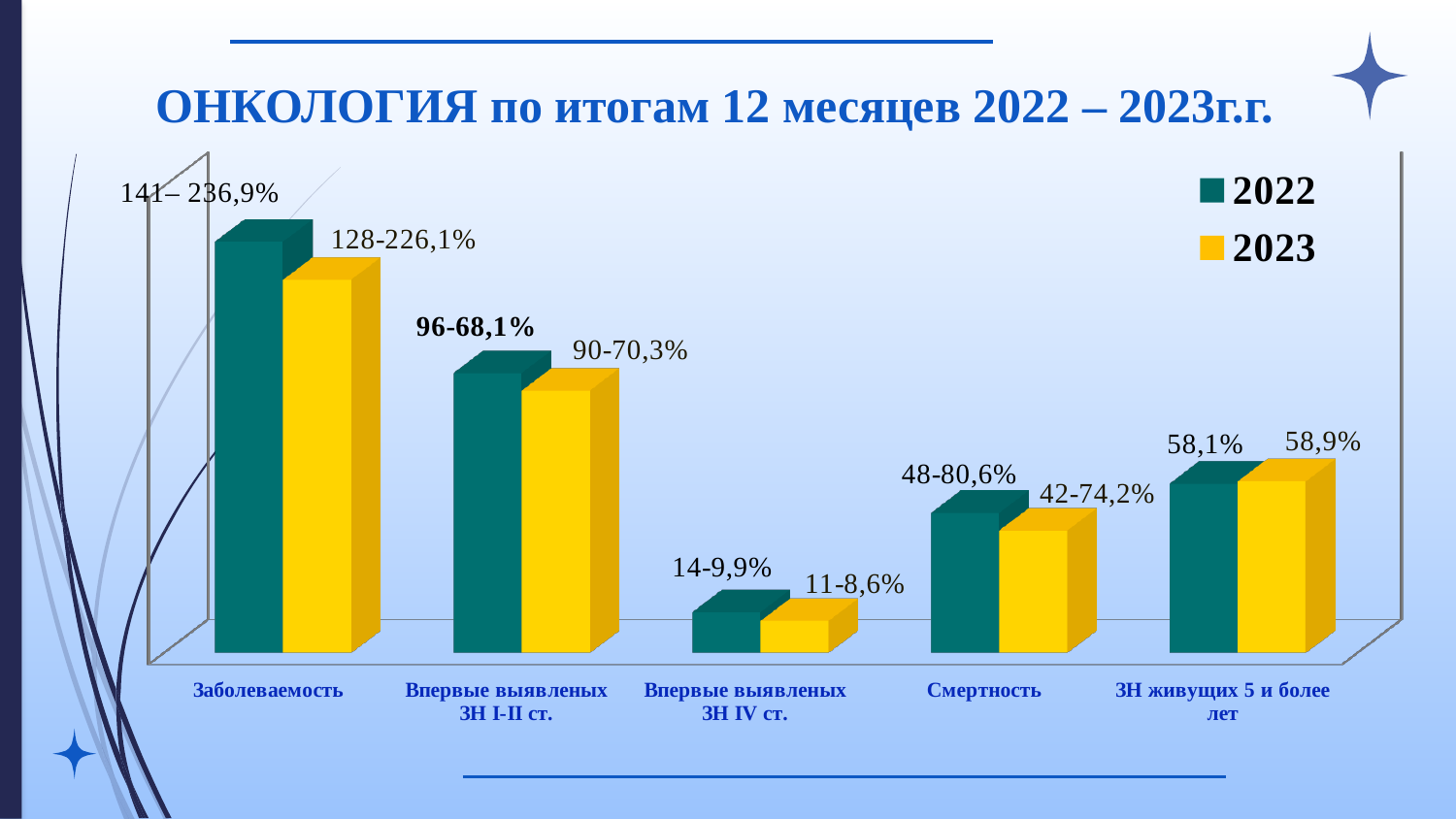
What is the data label for the 2023 bar in the Заболеваемость category? 128-226,1% What kind of chart is shown on the slide? bar chart How many categories are shown along the x axis? 5 In the Заболеваемость category, which series has the taller bar, 2022 or 2023? 2022 Which category has the tallest bars? Заболеваемость What is the data label for the 2022 bar in the Впервые выявленых ЗН IV ст. category? 14-9,9% How many series does the legend list? 2 Which category has the shortest bars? Впервые выявленых ЗН IV ст. What is the data label for the 2023 bar in the ЗН живущих 5 и более лет category? 58,9% What is the data label for the 2022 bar in the Впервые выявленых ЗН I-II ст. category? 96-68,1% What are the two entries in the chart legend? 2022 and 2023 What is the data label for the 2023 bar in the Смертность category? 42-74,2%